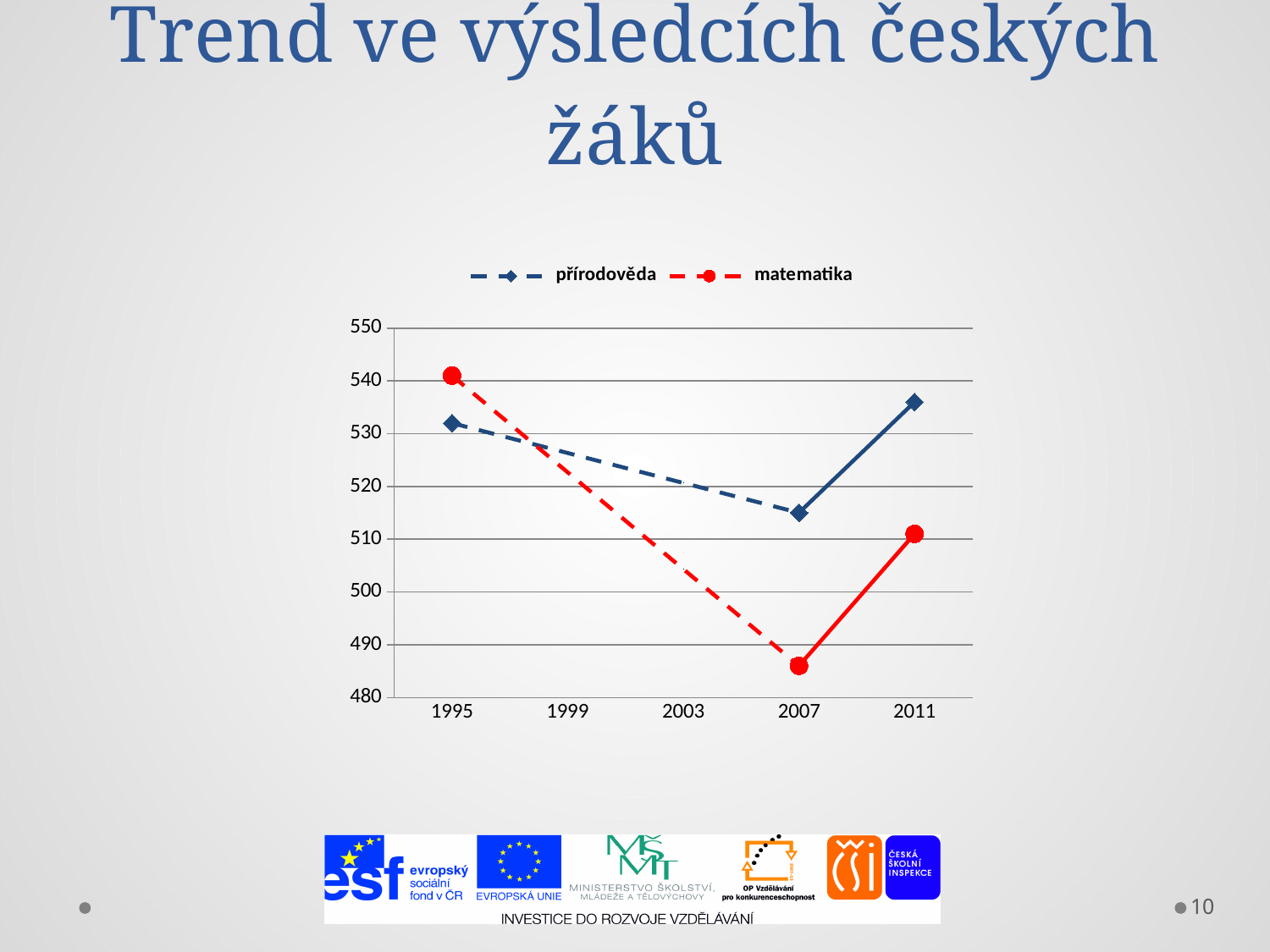
Is the matematika value for 2007 greater or less than 500? less In 1995, which series has the higher value, přírodověda or matematika? matematika In which year is the matematika value highest? 1995 Does the matematika value rise or fall from 1995 to 2007? fall In which year is the přírodověda value lowest? 2007 Which two series are listed in the legend? přírodověda and matematika In which year is the matematika value lowest? 2007 How many series does the legend list? 2 In 2007, which series has the higher value, přírodověda or matematika? přírodověda What colour is the matematika line? red What kind of chart is shown on the slide? line chart How many years are labelled on the x axis? 5